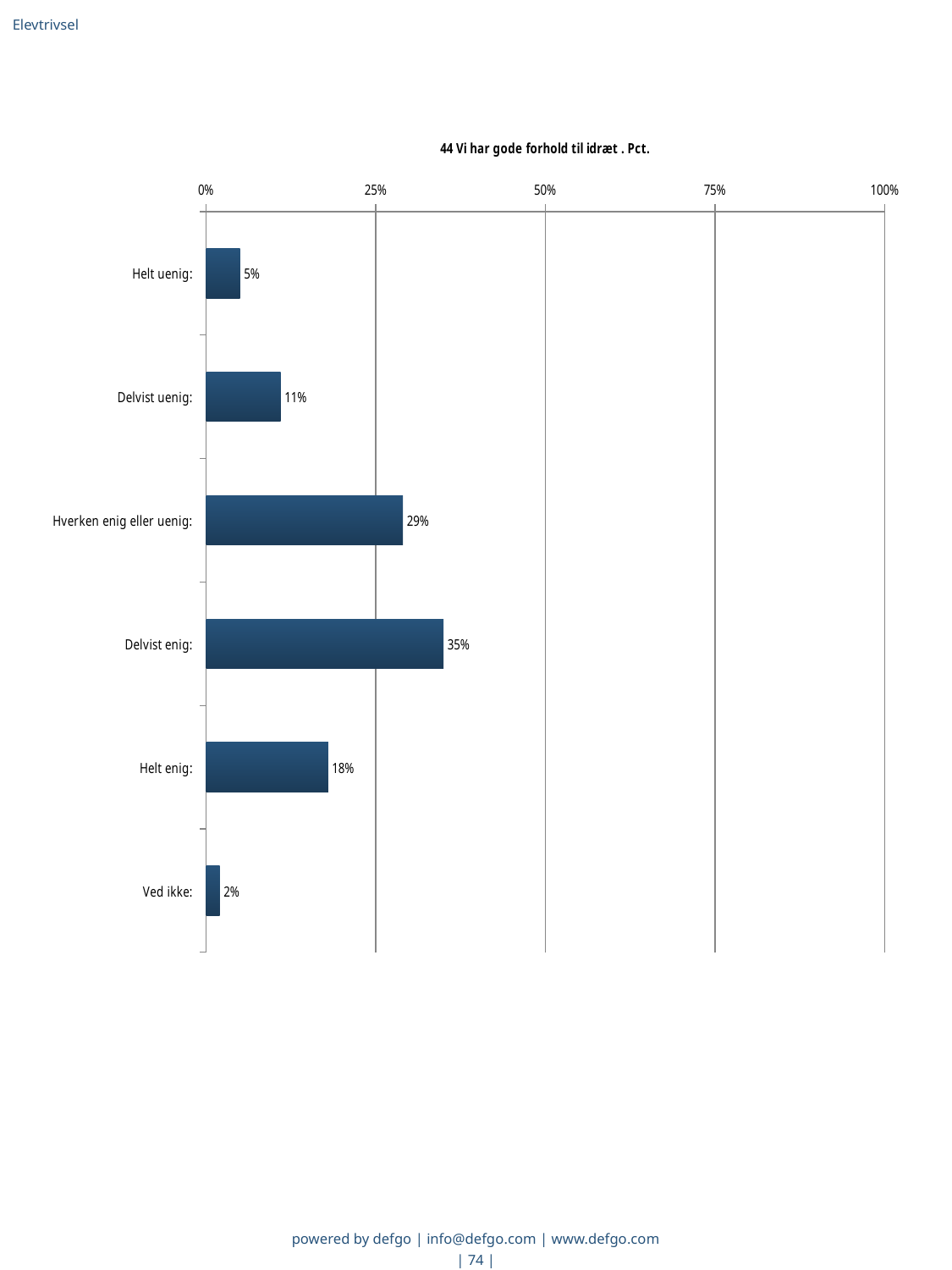
Which category has the lowest value? Ved ikke What is the value for "Delvist enig"? 35% What is the value for "Ved ikke"? 2% What is the title of the chart? 44 Vi har gode forhold til idræt . Pct. What kind of chart is shown on the slide? bar chart What is the value for "Helt uenig"? 5% Which is larger, the value for "Delvist uenig" or the value for "Helt enig"? Helt enig Which category has the highest value? Delvist enig What is the value for "Hverken enig eller uenig"? 29% Is the value for "Hverken enig eller uenig" greater or less than 25%? greater What is the difference between the values for "Delvist enig" and "Helt enig"? 17% How many categories are shown in the chart? 6